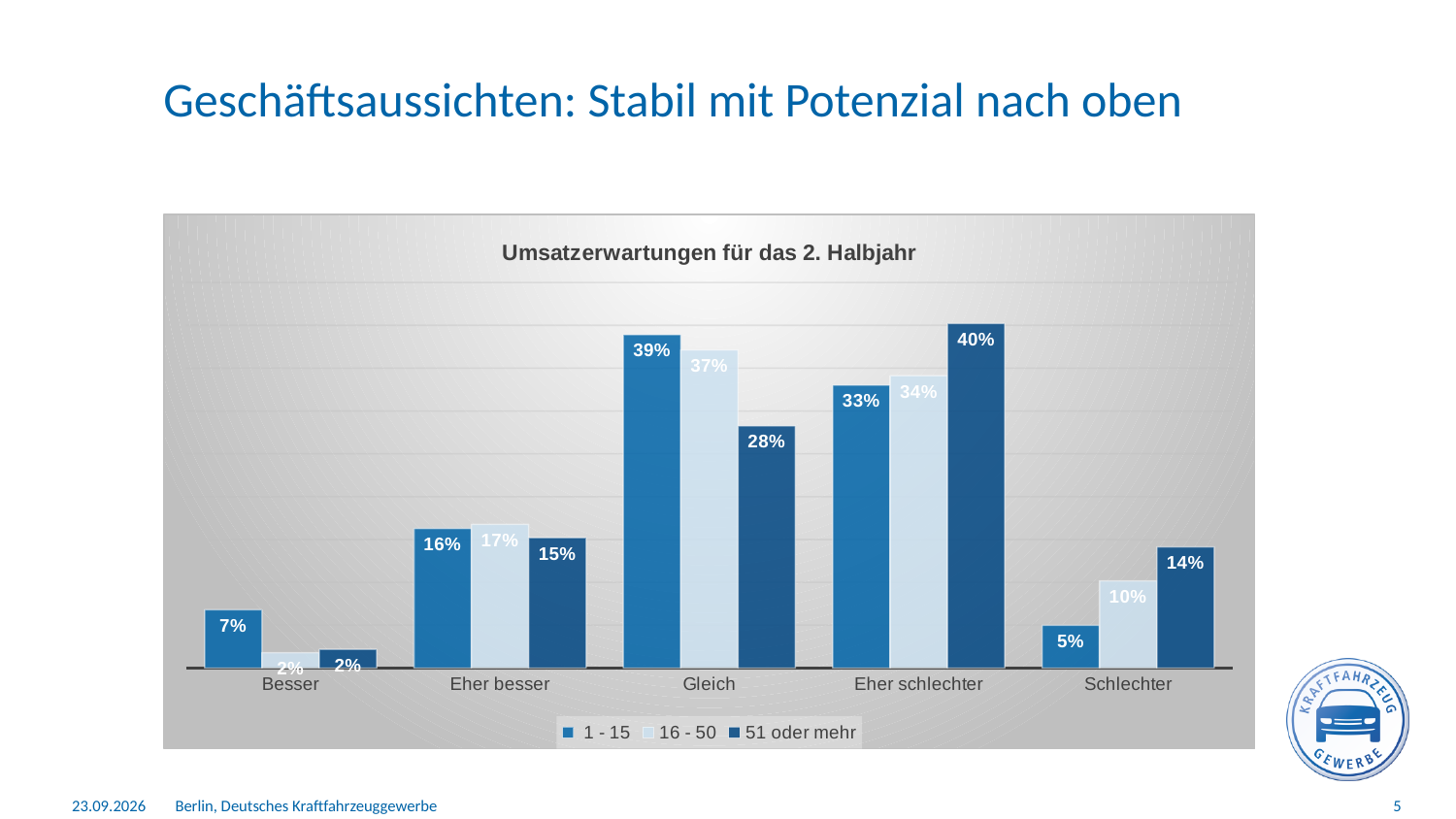
What is the title of the chart? Umsatzerwartungen für das 2. Halbjahr How many categories are shown on the x axis? 5 Which category has the highest value for the "51 oder mehr" series? Eher schlechter Which category has the lowest value for the "1 - 15" series? Schlechter In the "Besser" category, which series has the larger value: "1 - 15" or "16 - 50"? 1 - 15 What is the value for "1 - 15" in the "Gleich" category? 39% How many series does the legend list? 3 What is the value for "16 - 50" in the "Schlechter" category? 10% What is the difference between the "51 oder mehr" and "1 - 15" values in the "Schlechter" category? 9% What is the value for "51 oder mehr" in the "Eher schlechter" category? 40% What is the difference between the "1 - 15" and "51 oder mehr" values in the "Gleich" category? 11% What kind of chart is shown on the slide? bar chart